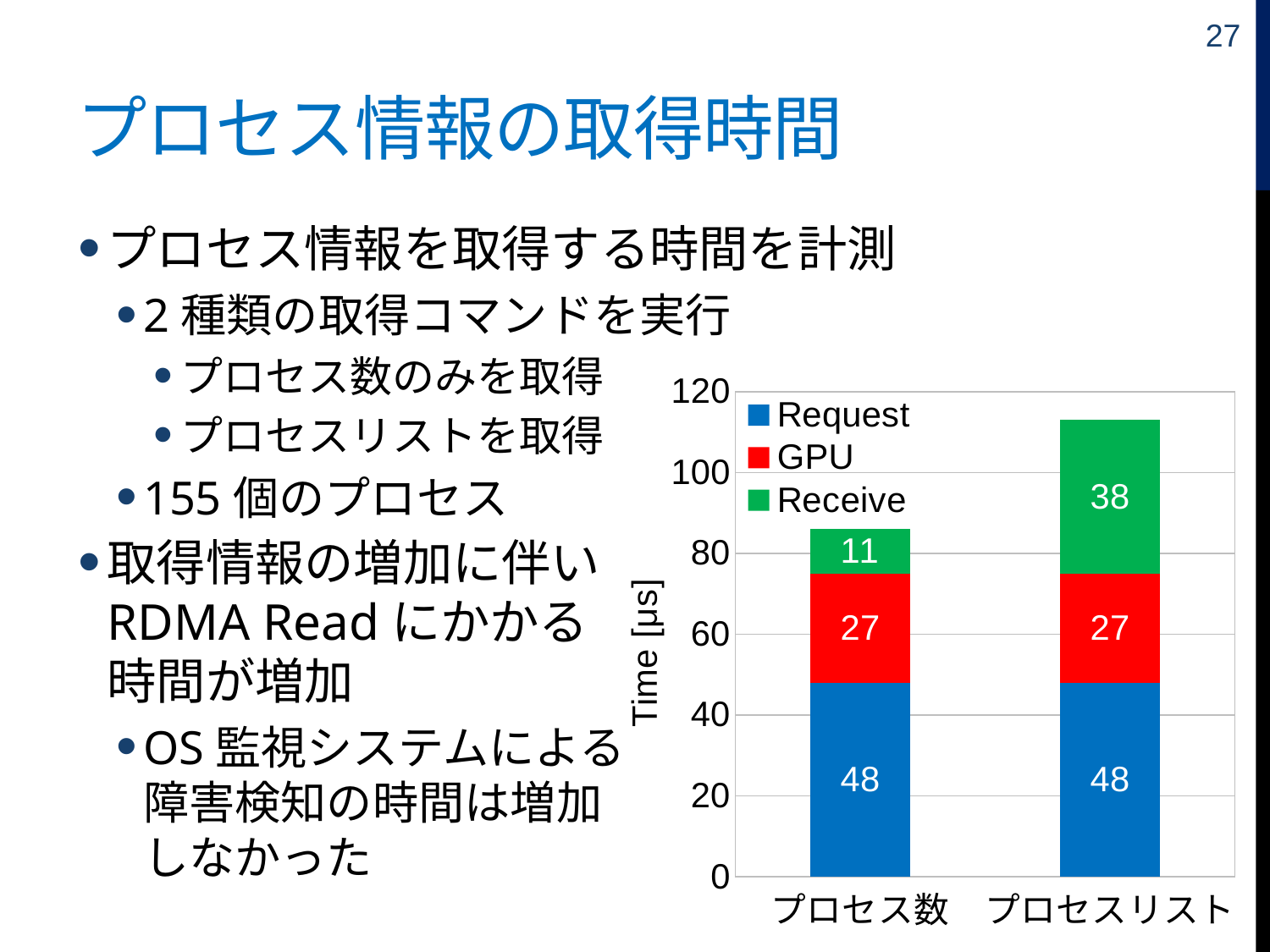
What is the Receive value for プロセス数? 11 What is the GPU value for プロセスリスト? 27 What is the difference between the Receive values for プロセスリスト and プロセス数? 27 What kind of chart is shown? stacked bar chart What is the Receive value for プロセスリスト? 38 How many series does the legend list? 3 Which category has the higher Receive value, プロセス数 or プロセスリスト? プロセスリスト How many categories are shown on the x axis? 2 Which category has the highest total bar? プロセスリスト What is the Request value for プロセス数? 48 What is the total of the stacked bar for プロセスリスト? 113 What is the total of the stacked bar for プロセス数? 86